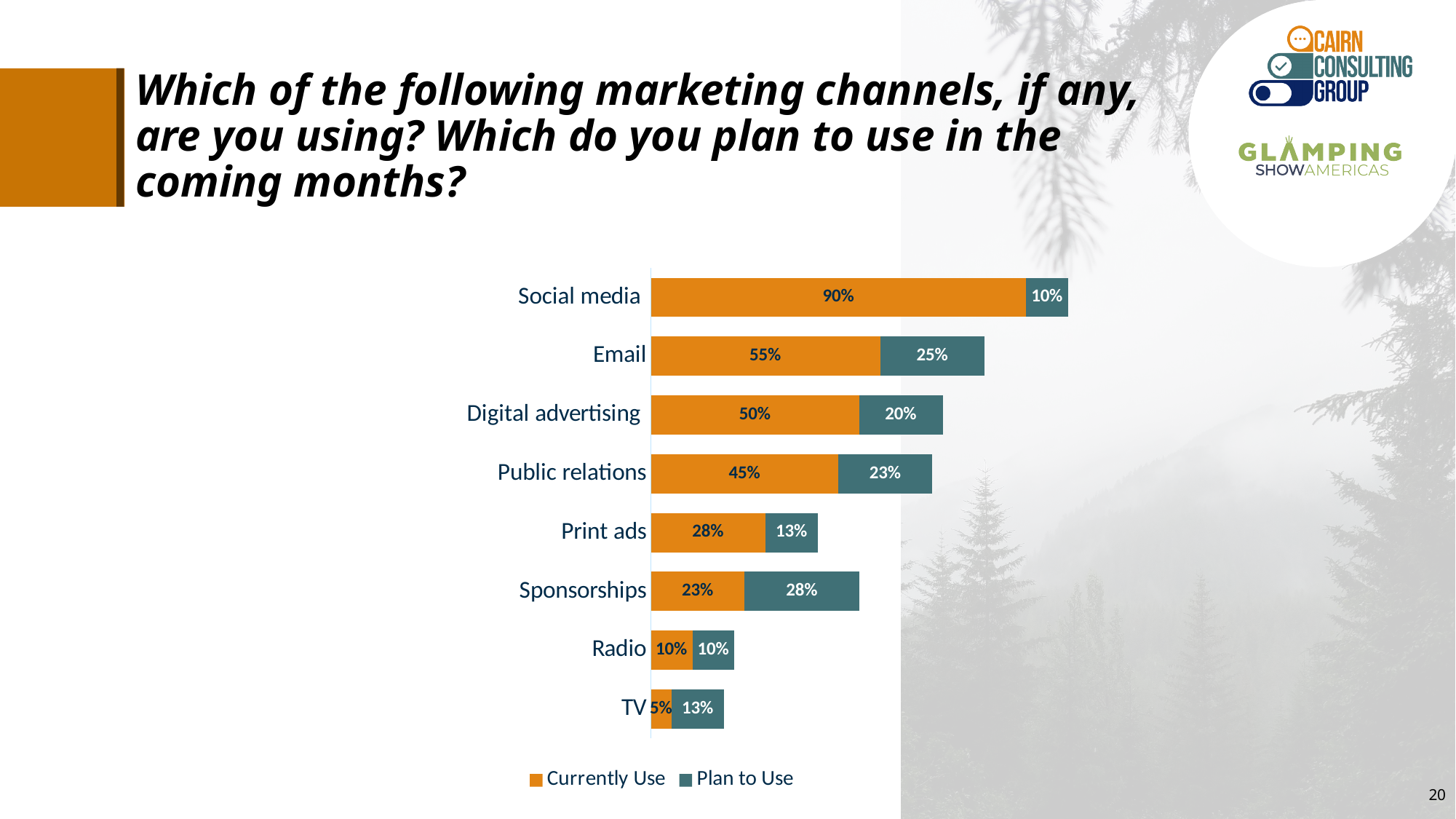
What percentage of respondents plan to use email? 25% How many series does the legend list? 2 How many marketing channels are shown in the chart? 8 What is the combined total of 'Currently Use' and 'Plan to Use' for public relations? 68% Which is larger for sponsorships: the 'Currently Use' value or the 'Plan to Use' value? Plan to Use What percentage of respondents currently use social media? 90% What is the difference between the 'Currently Use' percentages for email and digital advertising? 5% Which marketing channel has the highest 'Currently Use' percentage? Social media Which marketing channel has the lowest 'Currently Use' percentage? TV What kind of chart is shown on the slide? Stacked bar chart Which colour represents the 'Plan to Use' series? Dark teal What is the 'Currently Use' value for sponsorships? 23%